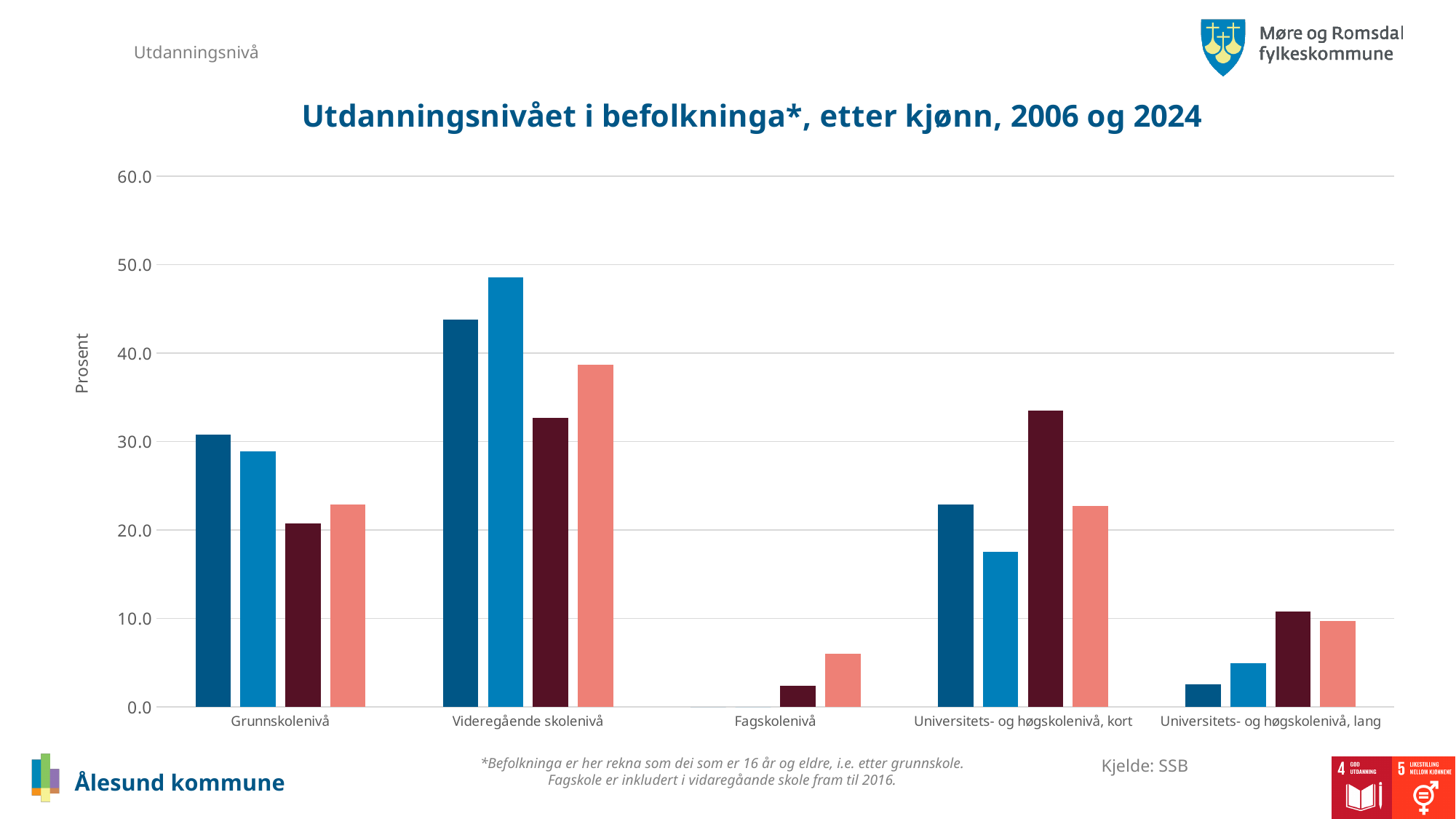
Which category has the tallest bar in the chart? Videregående skolenivå Which category has the lowest bars overall? Fagskolenivå For Universitets- og høgskolenivå, lang, which is larger: the dark blue (first) bar or the dark maroon (third) bar? the dark maroon (third) bar Is the value of the light blue (second) bar for Videregående skolenivå greater or less than 40? greater For Grunnskolenivå, which is larger: the dark blue (first) bar or the dark maroon (third) bar? the dark blue (first) bar What is the title of the chart? Utdanningsnivået i befolkninga*, etter kjønn, 2006 og 2024 How many bars are plotted for each category? 4 Is the value of the salmon (fourth) bar for Fagskolenivå greater or less than 10? less How many education-level categories are shown along the x axis? 5 What is the label on the y axis? Prosent What kind of chart is shown on the slide? bar chart Is the value of the dark maroon (third) bar for Universitets- og høgskolenivå, kort greater or less than 30? greater